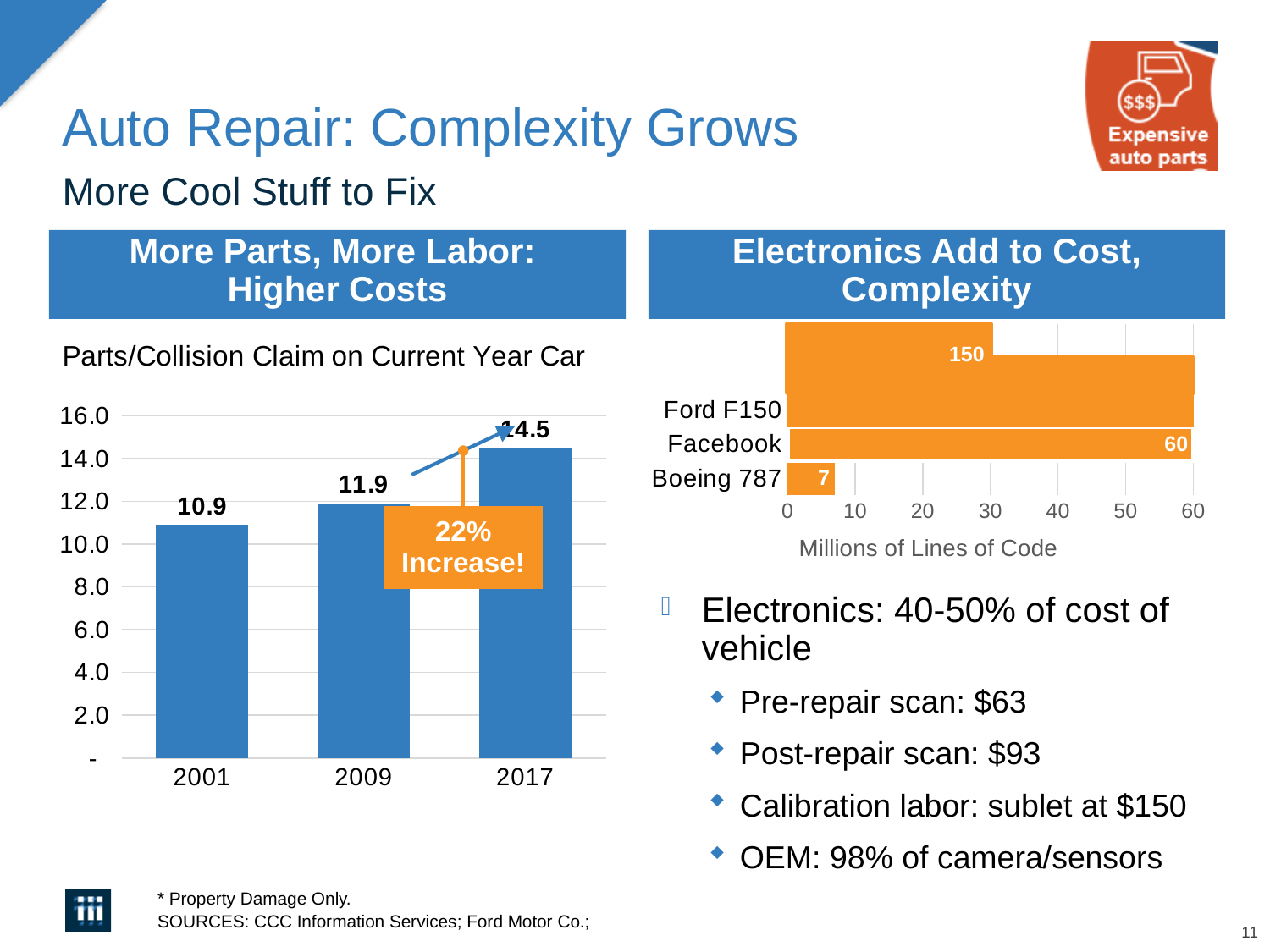
In the 'Millions of Lines of Code' chart, what is the value for Boeing 787? 7 In the 'Parts/Collision Claim on Current Year Car' chart, what is the value for 2017? 14.5 In the 'Millions of Lines of Code' chart, which is larger, Facebook or Boeing 787? Facebook In the 'Millions of Lines of Code' chart, what is the difference between the Facebook and Boeing 787 values? 53 In the 'Parts/Collision Claim on Current Year Car' chart, which year has the lowest value? 2001 In the 'Parts/Collision Claim on Current Year Car' chart, what is the difference between the 2017 and 2009 values? 2.6 In the 'Parts/Collision Claim on Current Year Car' chart, how many years are shown? 3 In the 'Millions of Lines of Code' chart, which category has the highest value? Ford F150 What kind of chart is the 'Parts/Collision Claim on Current Year Car' chart? bar chart In the 'Parts/Collision Claim on Current Year Car' chart, what is the value for 2001? 10.9 In the 'Millions of Lines of Code' chart, what is the value for Ford F150? 150 In the 'Parts/Collision Claim on Current Year Car' chart, do the values rise or fall from 2001 to 2017? rise